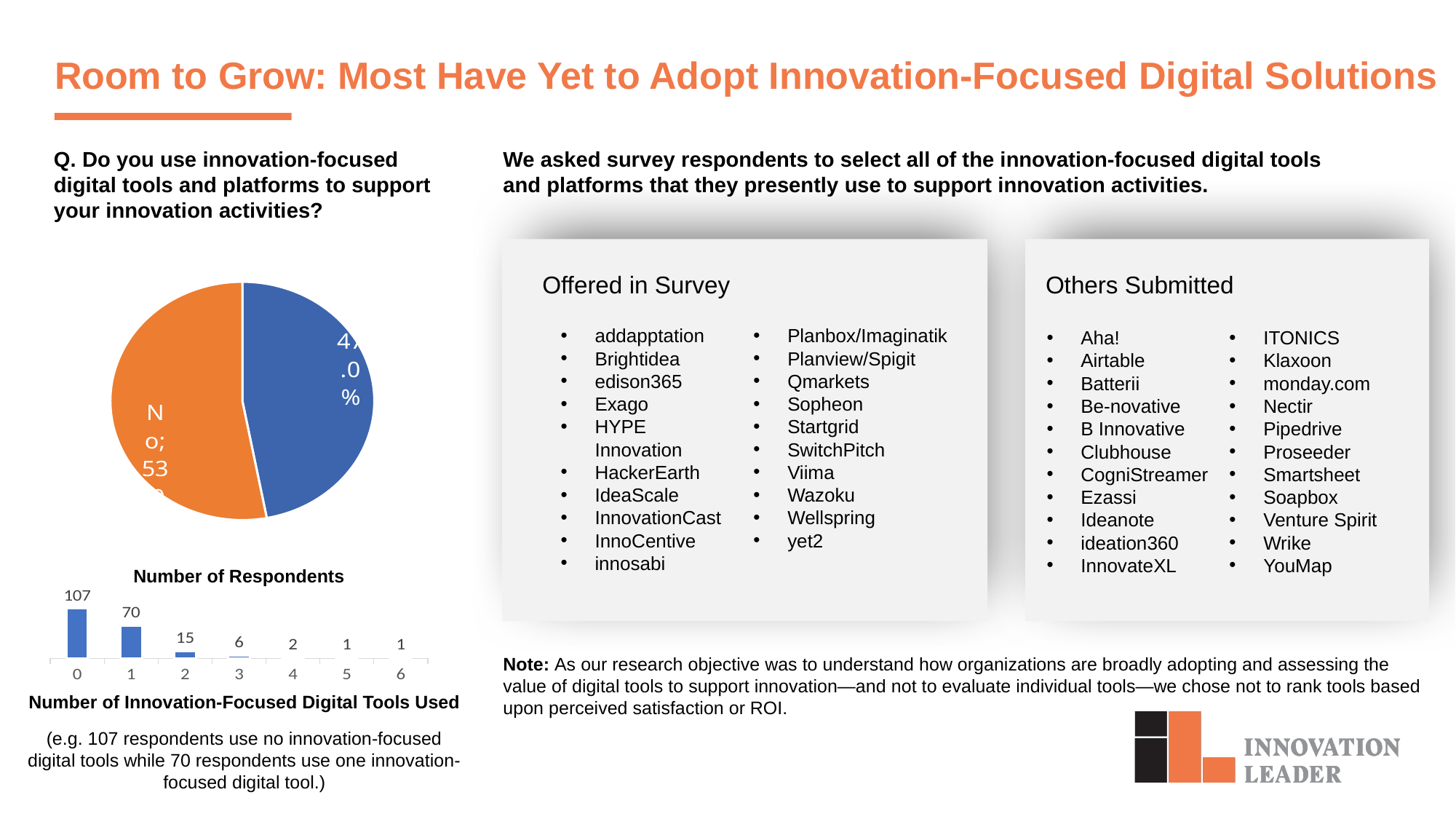
In the Number of Respondents bar chart, what is the difference between the values for 0 tools and 1 tool? 37 In the Number of Respondents bar chart, what is the difference between the values for 1 tool and 2 tools? 55 In the Number of Respondents bar chart, how many respondents use 0 innovation-focused digital tools? 107 In the Number of Respondents bar chart, do the values rise or fall as the number of tools used increases? fall What kind of chart is the Number of Respondents chart? bar chart In the Number of Respondents bar chart, which number of tools used has the highest number of respondents? 0 What kind of chart is used to show the answers to the question about using innovation-focused digital tools? pie chart How many categories are shown on the x axis of the Number of Respondents bar chart? 7 In the Number of Respondents bar chart, what is the value for 3 tools used? 6 In the Number of Respondents bar chart, which is larger: the value for 2 tools or the value for 3 tools? 2 tools In the Number of Respondents bar chart, how many respondents use 1 innovation-focused digital tool? 70 In the Number of Respondents bar chart, what is the value for 2 tools used? 15